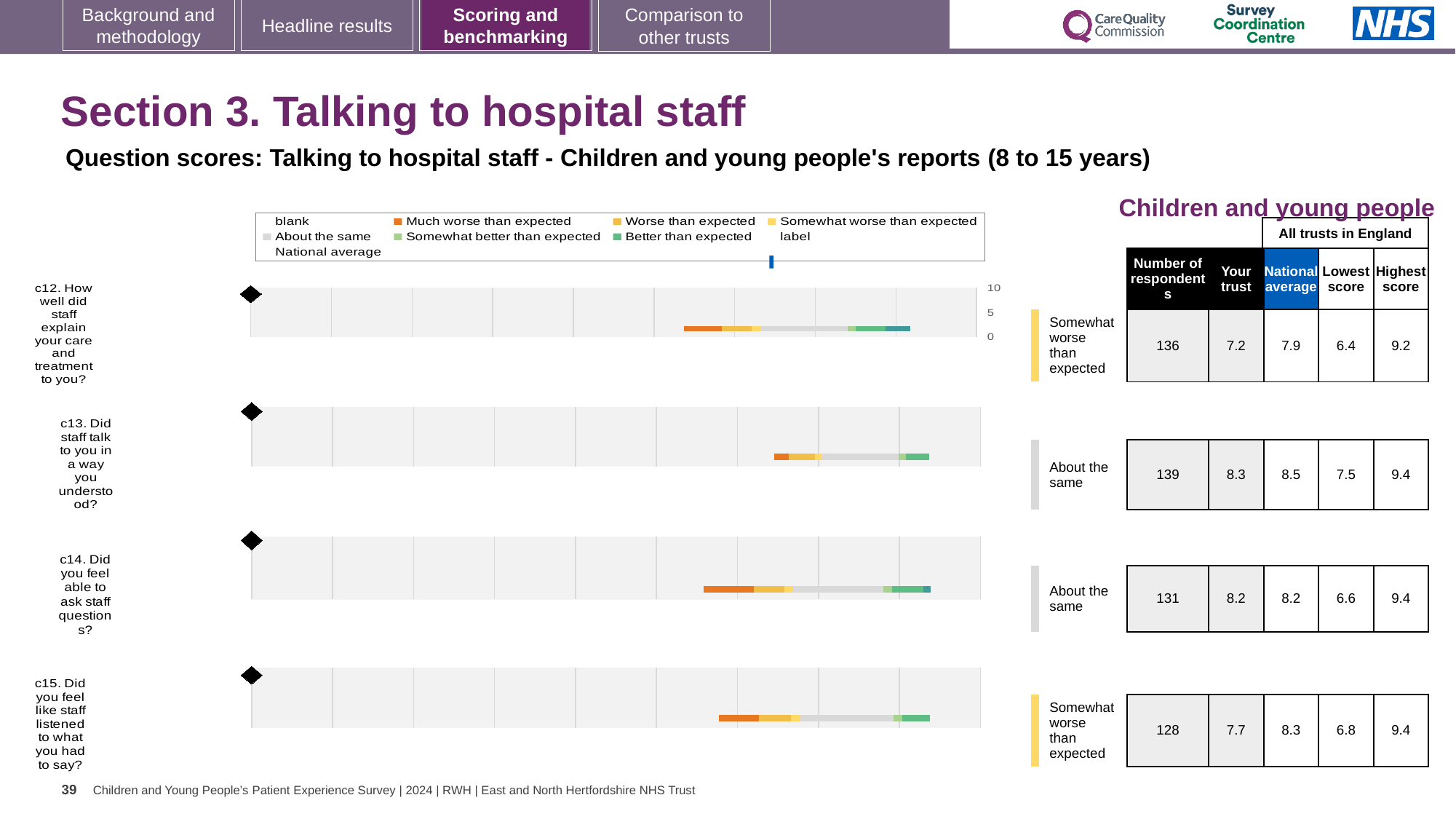
Which question has the lowest 'Your trust' score? c12 What kind of chart is used to show the question scores for c12 to c15? bar chart How many respondents answered c14 (Did you feel able to ask staff questions?)? 131 For c15, which is larger: the 'Your trust' score or the national average? National average What is the national average score for c13 (Did staff talk to you in a way you understood?)? 8.5 What is the maximum value shown on the score axis of the charts? 10 What is the difference between the national average and the 'Your trust' score for c12? 0.7 What is the highest score across all trusts in England for c15 (Did you feel like staff listened to what you had to say?)? 9.4 What is the 'Your trust' score for c12 (How well did staff explain your care and treatment to you?)? 7.2 How many questions (c12 to c15) are plotted on the slide? 4 What benchmark category is shown for c12 (How well did staff explain your care and treatment to you?)? Somewhat worse than expected Which question has the highest 'Your trust' score? c13